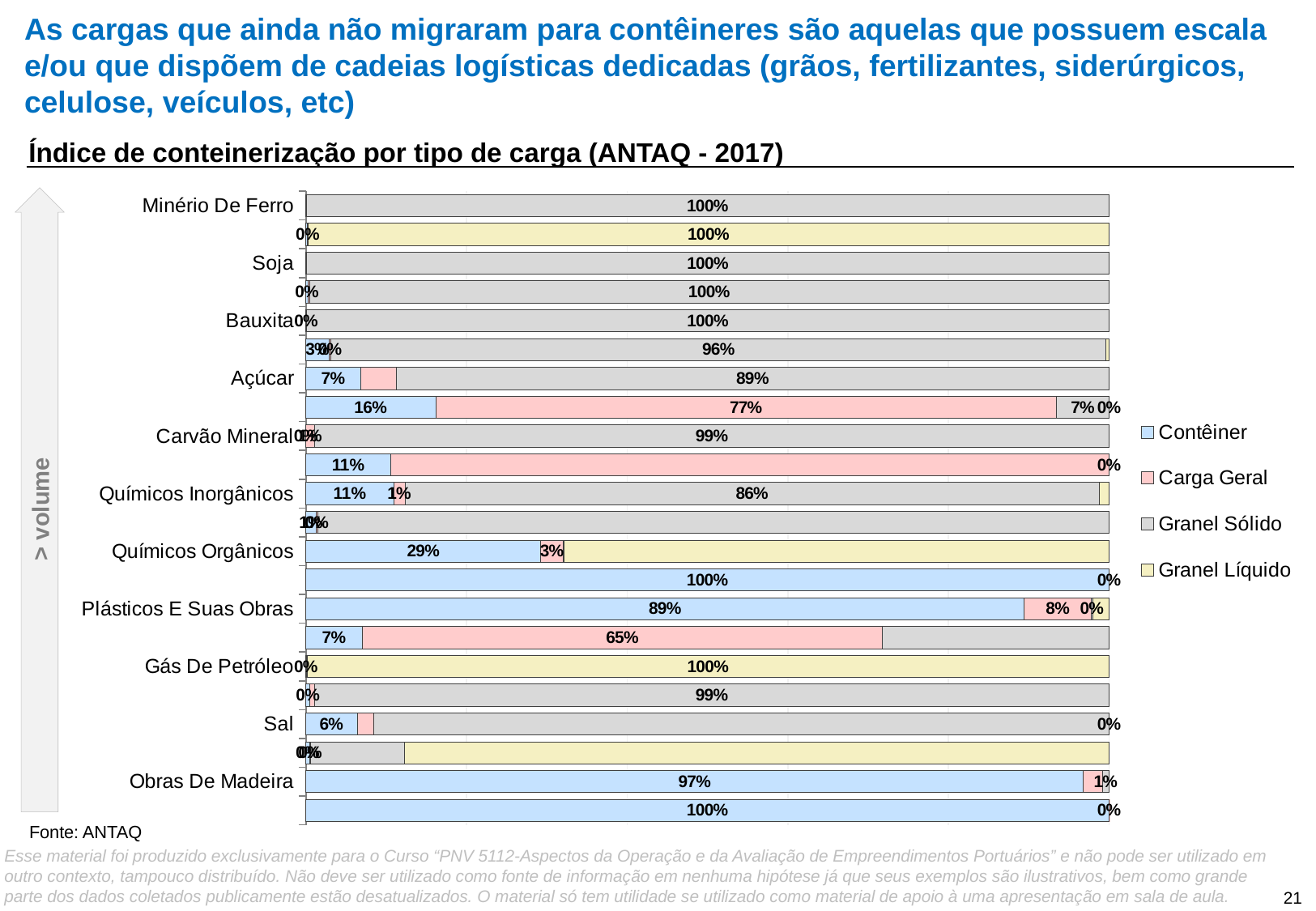
What is the Granel Sólido share for Açúcar? 89% What is the Contêiner share for Químicos Inorgânicos? 11% How many series does the legend list? 4 Which series are listed in the legend? Contêiner, Carga Geral, Granel Sólido, Granel Líquido What is the Contêiner share for Plásticos E Suas Obras? 89% What is the difference between the Contêiner share of Químicos Inorgânicos and that of Açúcar? 4% What kind of chart is shown on the slide? Stacked bar chart What is the Granel Sólido share for Minério De Ferro? 100% Which has a larger Contêiner share, Plásticos E Suas Obras or Açúcar? Plásticos E Suas Obras What is the Contêiner share for Obras De Madeira? 97% What is the Contêiner share for Açúcar? 7% What is the Granel Líquido share for Gás De Petróleo? 100%